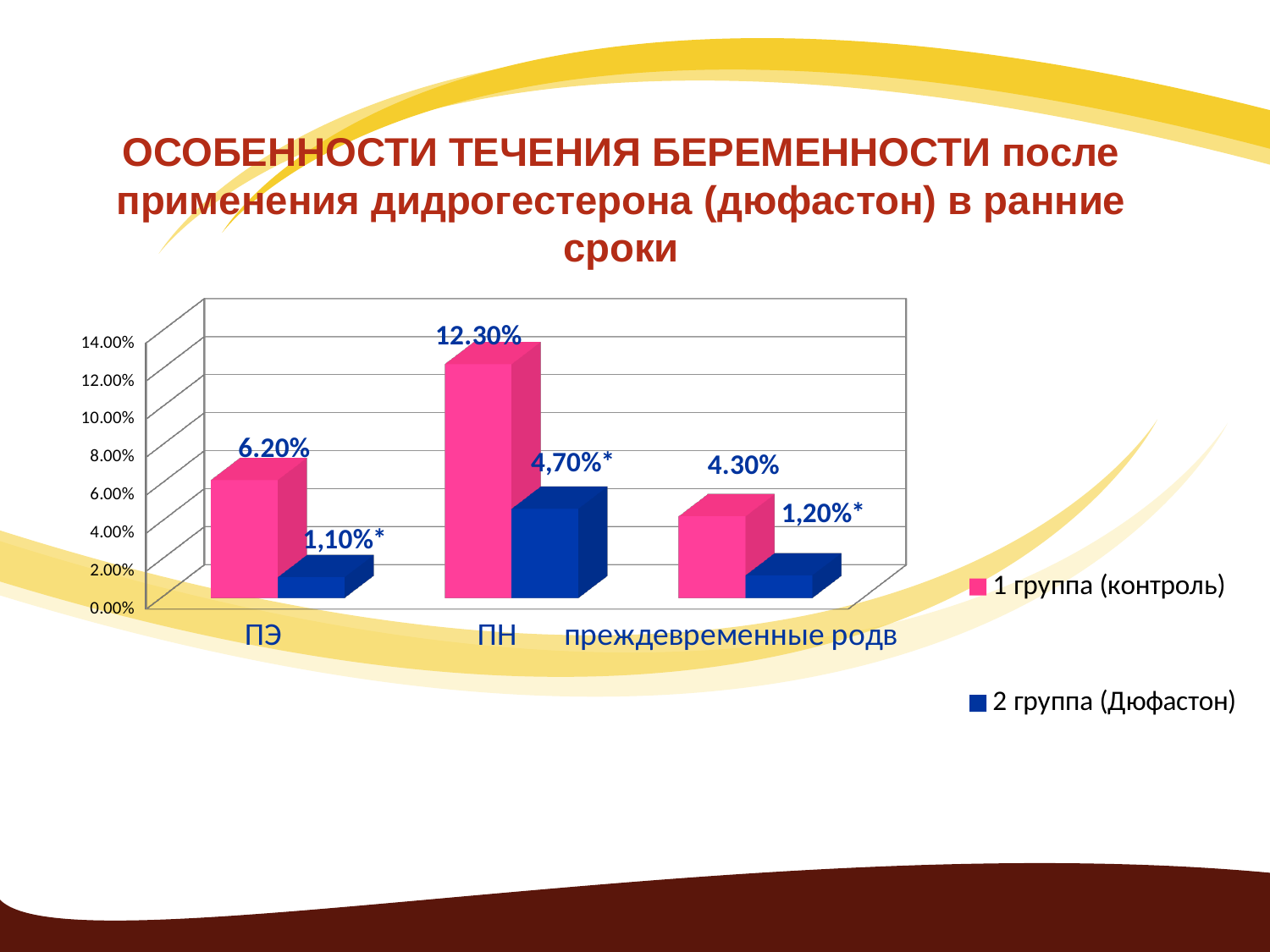
What is the value for преждевременные родв in the 1 группа (контроль) series? 4.30% For ПЭ, which series has the larger value: 1 группа (контроль) or 2 группа (Дюфастон)? 1 группа (контроль) What is the difference between the 1 группа (контроль) values for ПН and ПЭ? 6.10% What is the value for ПН in the 2 группа (Дюфастон) series? 4,70%* What is the value for ПН in the 1 группа (контроль) series? 12.30% What kind of chart is shown on the slide? Bar chart Which colour represents the 2 группа (Дюфастон) series? Blue How many categories are shown on the x axis? 3 What is the value for ПЭ in the 2 группа (Дюфастон) series? 1,10%* Which category has the highest value in the 1 группа (контроль) series? ПН Which category has the lowest value in the 2 группа (Дюфастон) series? ПЭ How many series does the legend list? 2